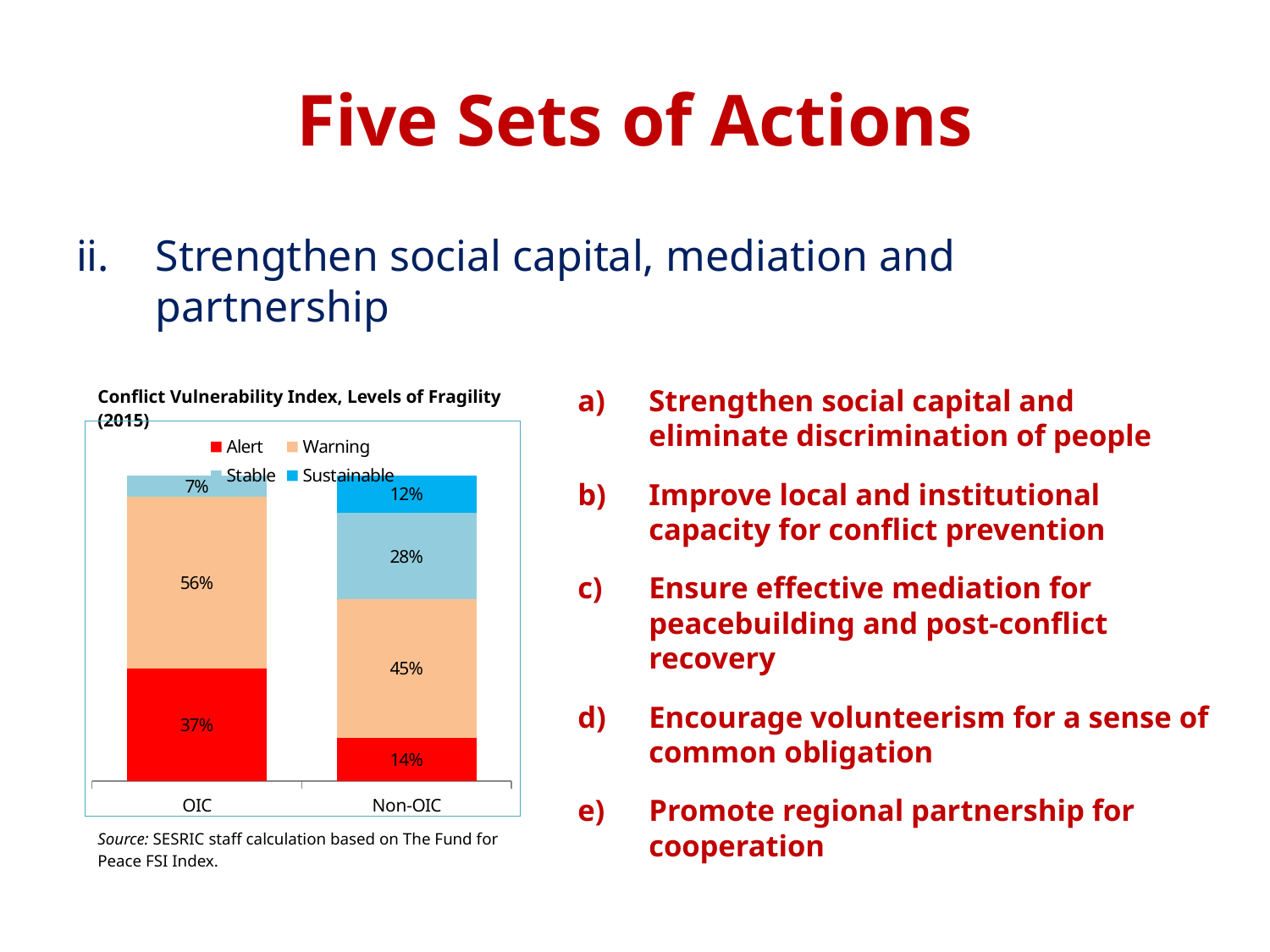
How many series does the legend list? 4 What is the Stable value for Non-OIC? 28% Which category has the higher Alert value, OIC or Non-OIC? OIC What kind of chart is shown on the slide? Stacked bar chart Which labelled series has the smallest share in the Non-OIC bar? Sustainable Which series has the largest share in the OIC bar? Warning What is the difference between the Warning values for OIC and Non-OIC? 11% What is the Stable value for OIC? 7% What is the Sustainable value for Non-OIC? 12% What is the Warning value for Non-OIC? 45% What is the Alert value for OIC in the Conflict Vulnerability Index chart? 37% What is the difference between the Alert values for OIC and Non-OIC? 23%